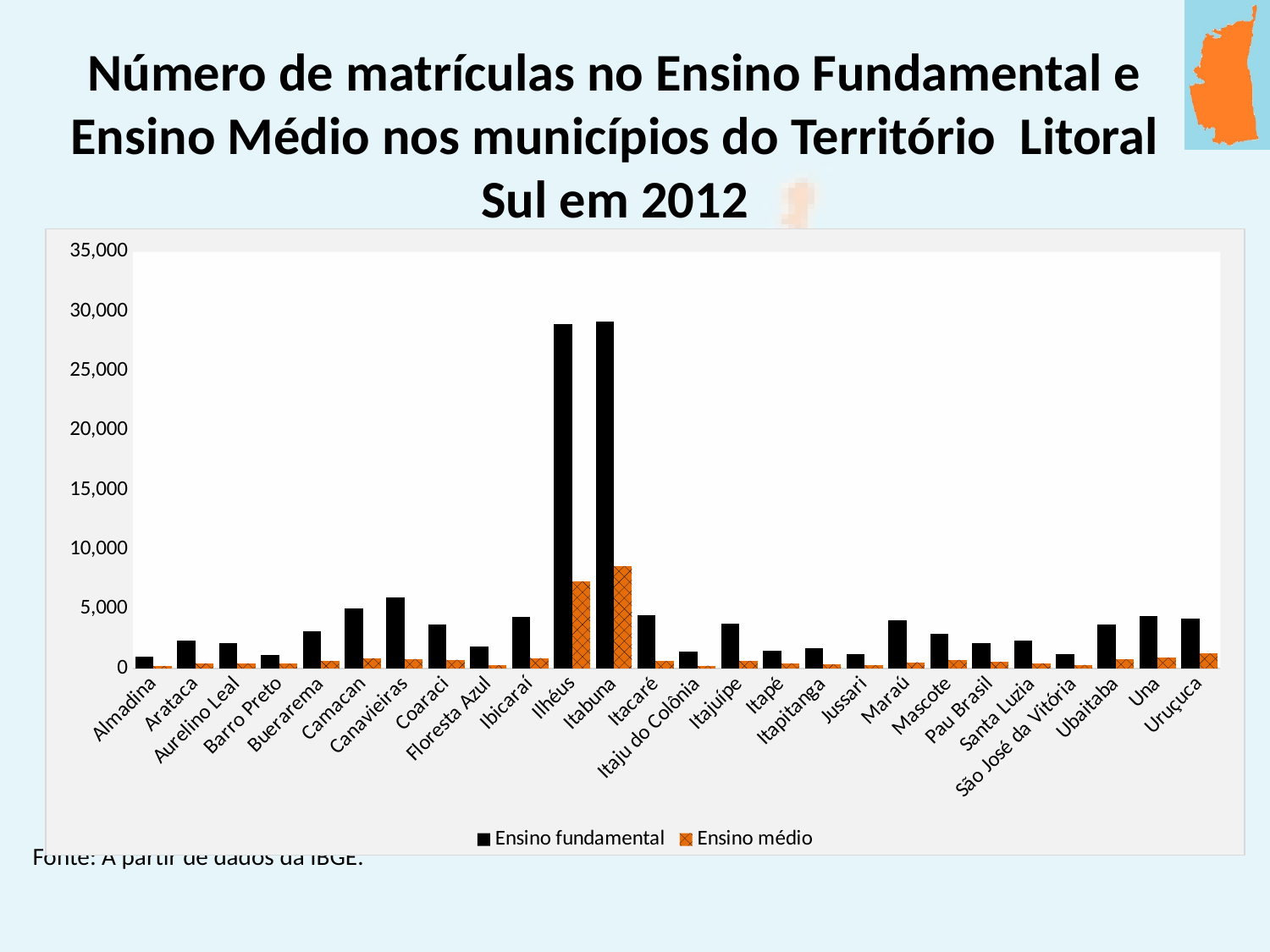
Is the Ensino fundamental value for Ilhéus greater or less than 25,000? greater Is the Ensino fundamental value for Canavieiras greater or less than 5,000? greater Is the Ensino médio value for Itabuna greater or less than 5,000? greater What kind of chart is shown on the slide? Bar chart Which has the larger Ensino fundamental value, Canavieiras or Coaraci? Canavieiras Which has the larger Ensino médio value, Ilhéus or Itabuna? Itabuna Which municipality has the highest value for Ensino médio? Itabuna Which series is shown with black bars? Ensino fundamental How many municipalities are shown on the x axis? 26 How many series does the legend list? 2